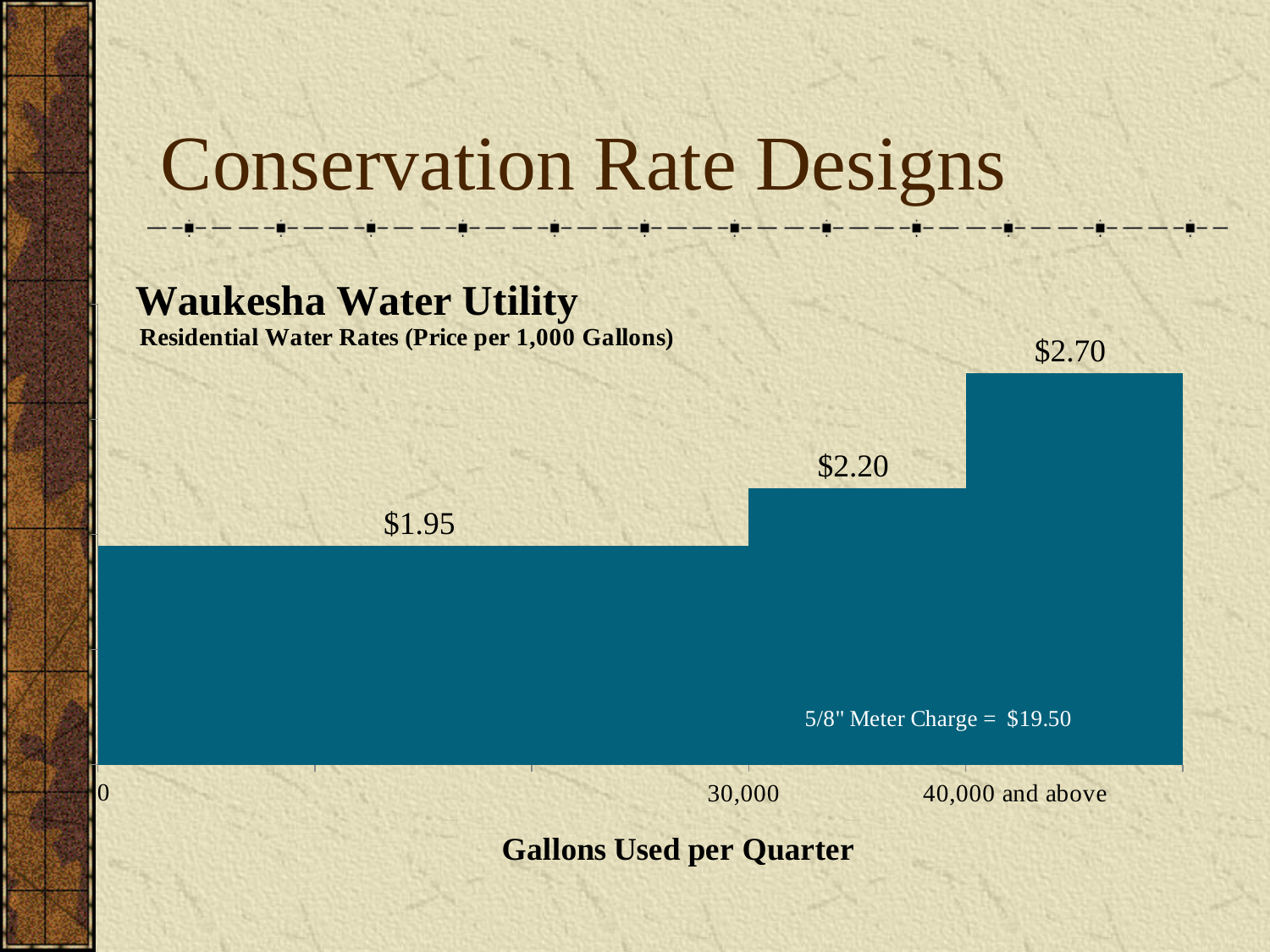
What is the price per 1,000 gallons for usage from 0 to 30,000 gallons per quarter? $1.95 What is the label of the x axis of the chart? Gallons Used per Quarter Which is higher: the rate for the 30,000 to 40,000 tier or the rate for the 40,000 and above tier? 40,000 and above What is the price per 1,000 gallons for usage of 40,000 gallons and above per quarter? $2.70 What is the difference in price per 1,000 gallons between the 30,000 to 40,000 tier and the 0 to 30,000 tier? $0.25 Which usage tier has the highest price per 1,000 gallons? 40,000 and above What is the price per 1,000 gallons for usage between 30,000 and 40,000 gallons per quarter? $2.20 Which usage tier has the lowest price per 1,000 gallons? 0 to 30,000 How many rate tiers are shown in the chart? 3 What is the 5/8" meter charge shown on the chart? $19.50 What is the difference in price per 1,000 gallons between the 40,000 and above tier and the 0 to 30,000 tier? $0.75 Do the rates rise or fall as gallons used per quarter increases? Rise